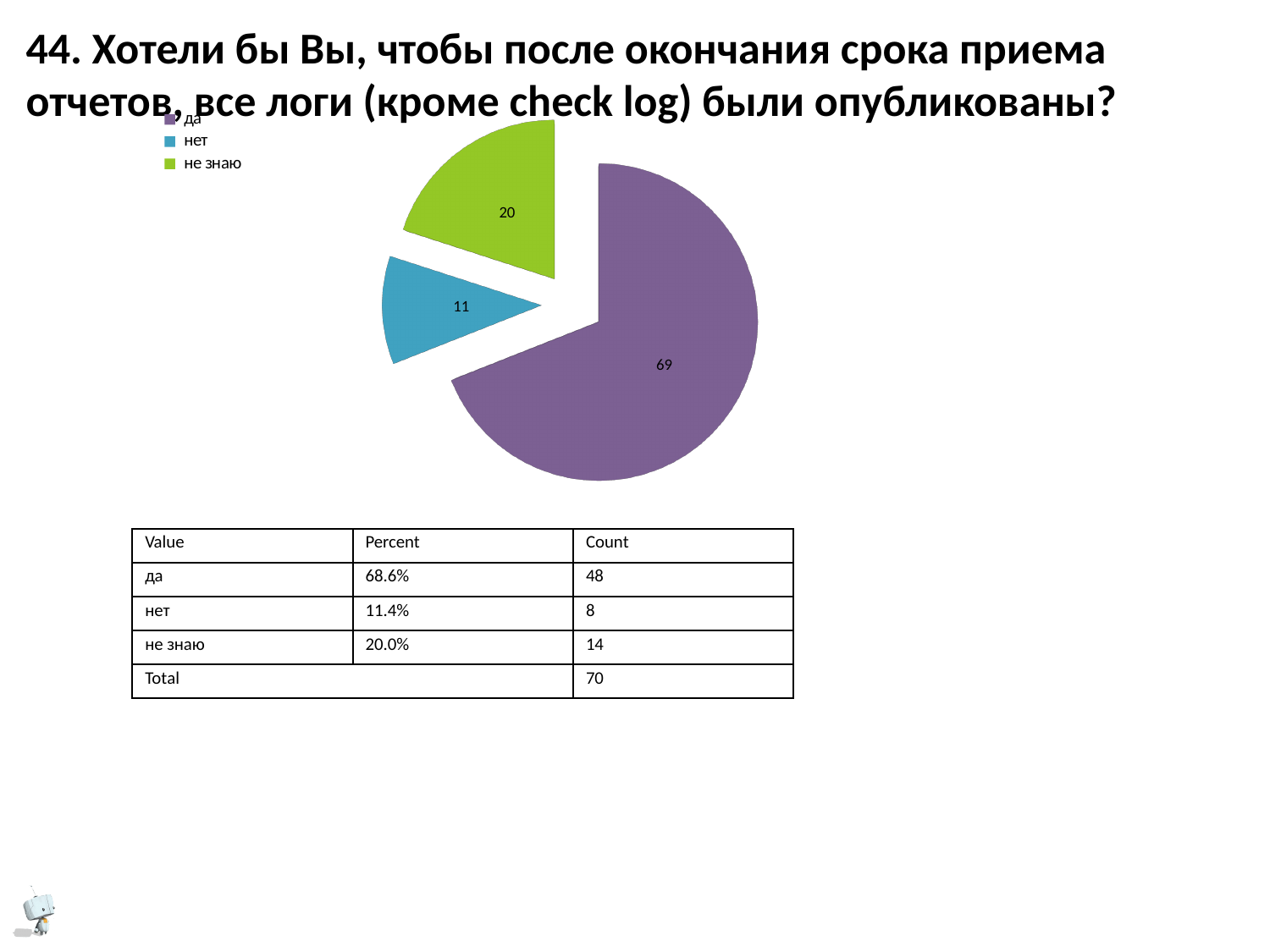
What value is labelled on the pie slice for "да"? 69 Which category has the largest slice in the pie chart? да What value is labelled on the pie slice for "не знаю"? 20 What is the difference between the labelled values for "да" and "не знаю" in the pie chart? 49 Which slice is larger in the pie chart, "нет" or "не знаю"? не знаю What colour is the "да" slice in the pie chart? purple What value is labelled on the pie slice for "нет"? 11 How many slices does the pie chart have? 3 How many entries does the legend of the pie chart list? 3 What is the difference between the labelled values for "не знаю" and "нет" in the pie chart? 9 Which category has the smallest slice in the pie chart? нет What kind of chart is shown on the slide? pie chart